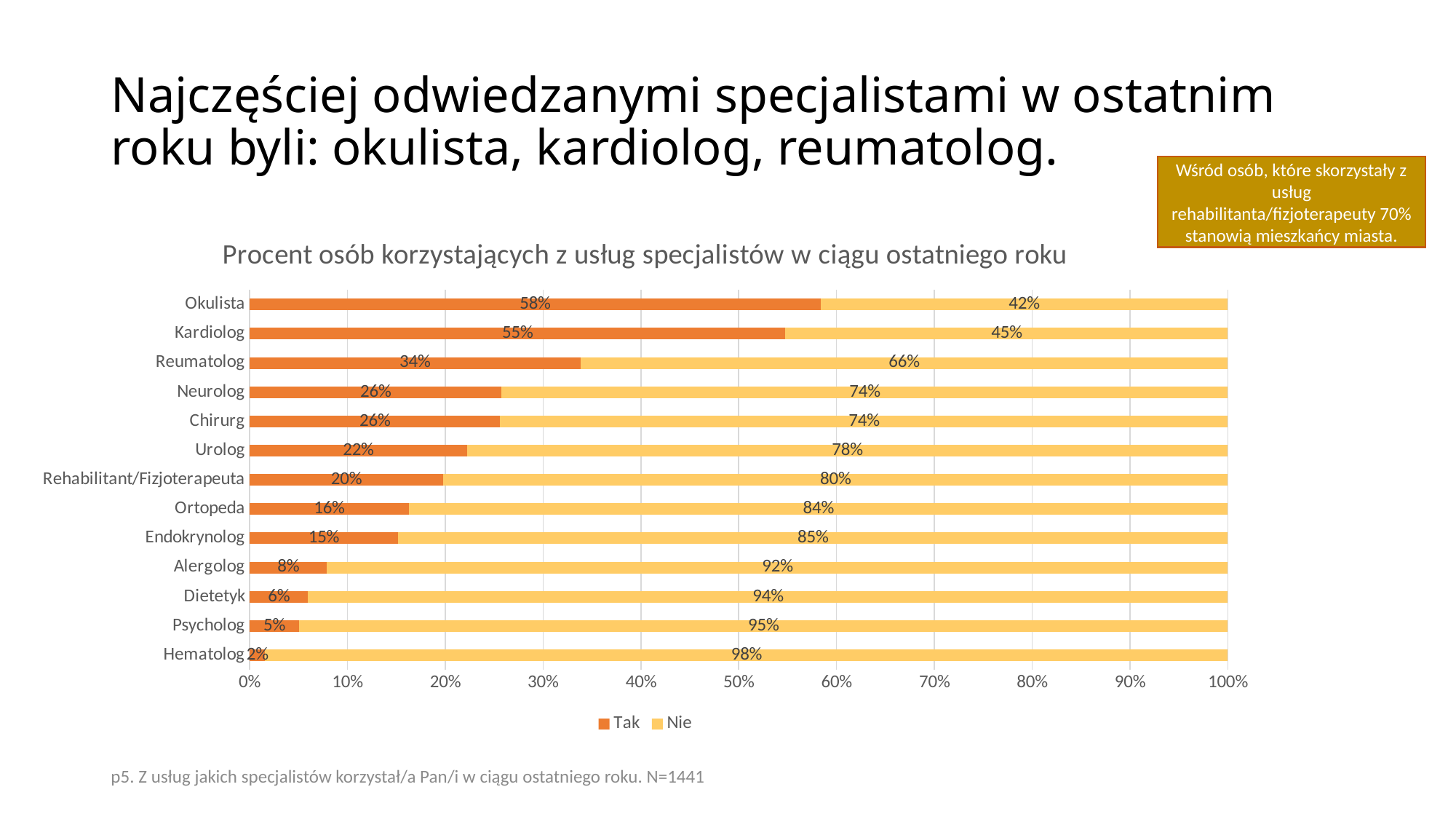
What is the "Nie" value for Reumatolog? 66% How many categories are shown on the chart? 13 What is the title of the chart? Procent osób korzystających z usług specjalistów w ciągu ostatniego roku Which has a larger "Tak" value, Urolog or Ortopeda? Urolog Is the "Tak" value for Reumatolog greater or less than 30%? greater What is the difference between the "Tak" values for Okulista and Kardiolog? 3% Which category has the highest "Tak" value? Okulista Which category has the lowest "Tak" value? Hematolog What kind of chart is shown on the slide? Stacked bar chart What is the "Tak" value for Okulista? 58% How many series does the legend list? 2 What is the "Tak" value for Rehabilitant/Fizjoterapeuta? 20%